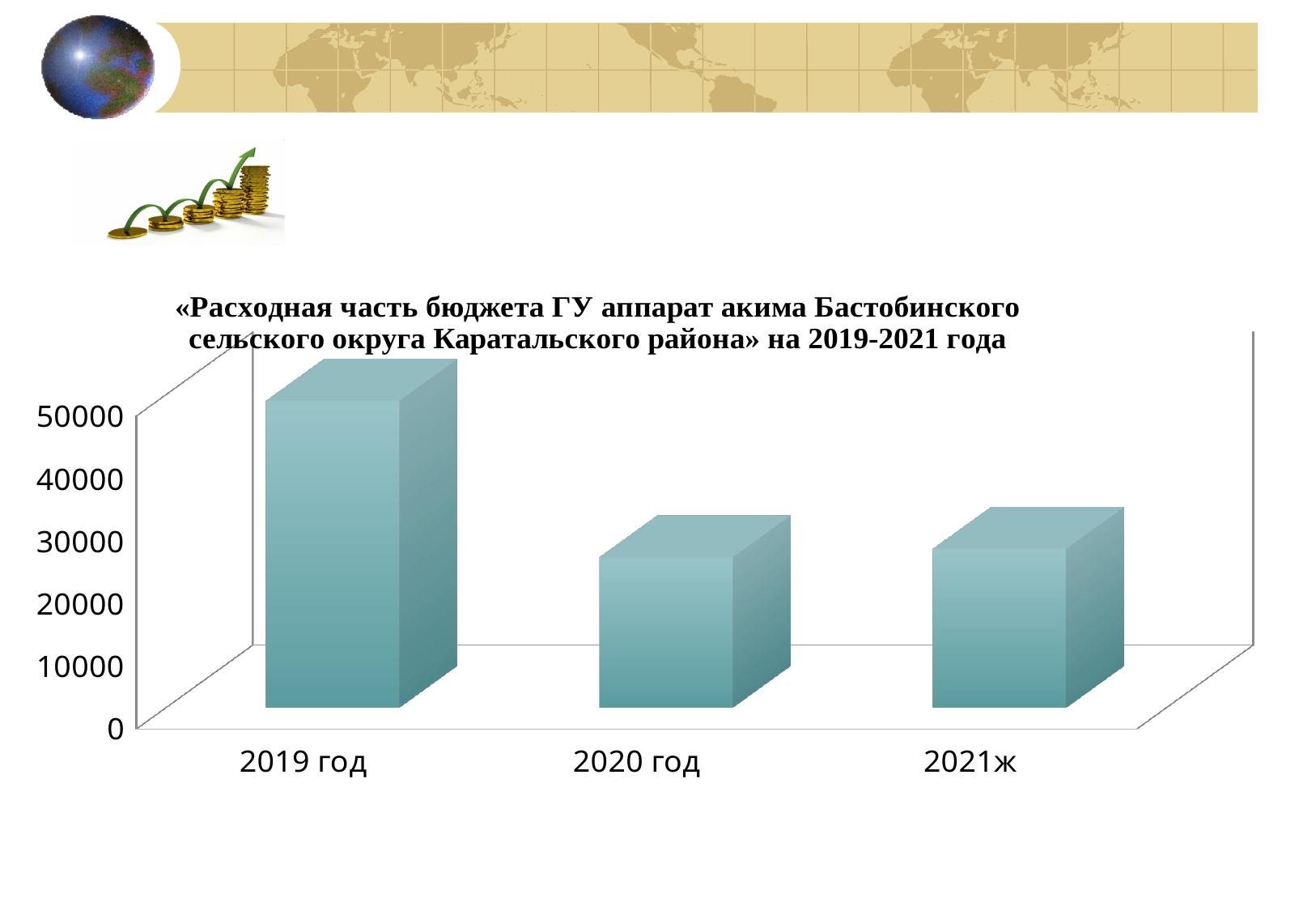
Is the value for 2021ж greater or less than 40000? less What is the highest tick value shown on the vertical axis of the chart? 50000 Does the value fall or rise from 2019 год to 2020 год? fall Is the value for 2020 год greater or less than 20000? greater Which is larger, the value for 2019 год or the value for 2021ж? 2019 год Which year has the highest value in the chart? 2019 год What kind of chart is shown on the slide? bar chart Is the value for 2019 год greater or less than 40000? greater Which is larger, the value for 2019 год or the value for 2020 год? 2019 год How many categories (years) are shown on the x axis of the chart? 3